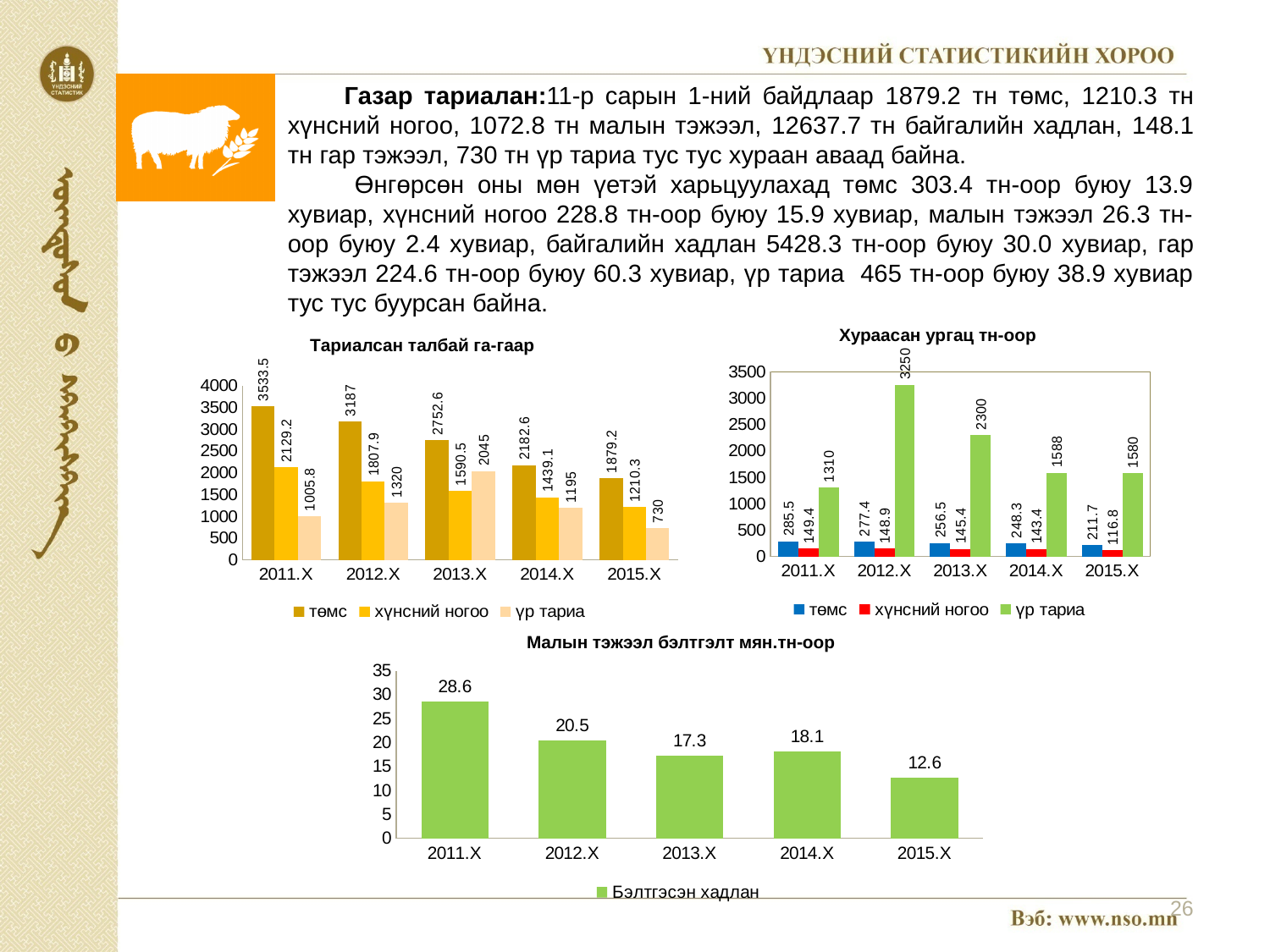
In the chart titled "Тариалсан талбай га-гаар", does the value for төмс rise or fall from 2011.X to 2015.X? fall In the chart titled "Тариалсан талбай га-гаар", what is the value for үр тариа in 2013.X? 2045 In the chart titled "Тариалсан талбай га-гаар", which year has the lowest value for хүнсний ногоо? 2015.X In the chart titled "Хураасан ургац тн-оор", which year has the highest value for үр тариа? 2012.X What kind of chart is the one titled "Малын тэжээл бэлтгэлт мян.тн-оор"? bar chart In the chart titled "Хураасан ургац тн-оор", what is the value for үр тариа in 2012.X? 3250 In the chart titled "Тариалсан талбай га-гаар", what is the value for төмс in 2011.X? 3533.5 In the chart titled "Тариалсан талбай га-гаар", what is the difference between the төмс values for 2011.X and 2015.X? 1654.3 In the chart titled "Малын тэжээл бэлтгэлт мян.тн-оор", what is the value for 2014.X? 18.1 In the chart titled "Хураасан ургац тн-оор", which is larger: төмс in 2011.X or төмс in 2015.X? төмс in 2011.X In the chart titled "Хураасан ургац тн-оор", how many series does the legend list? 3 In the chart titled "Малын тэжээл бэлтгэлт мян.тн-оор", what is the difference between the values for 2011.X and 2015.X? 16.0